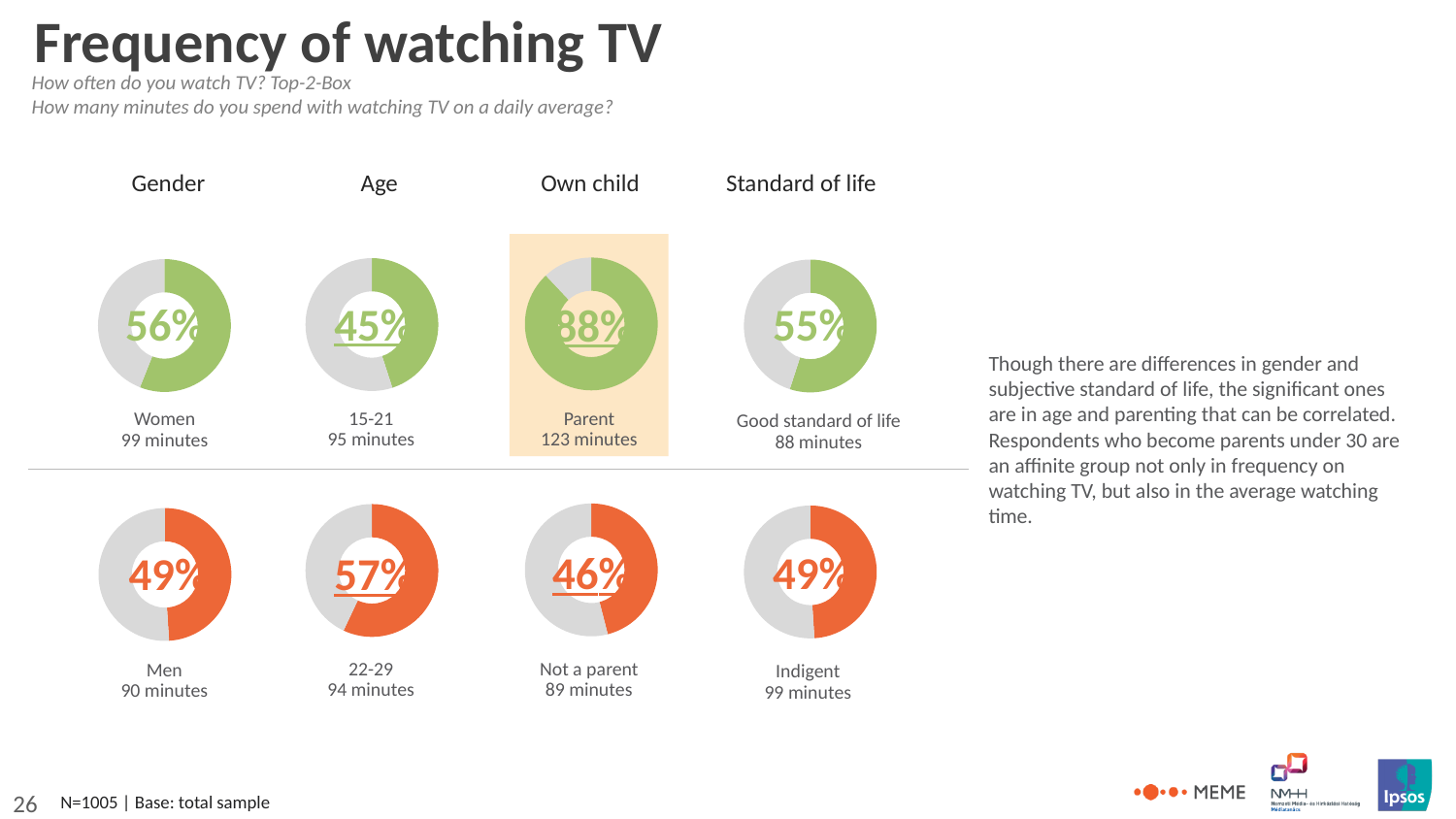
How many donut charts are shown on the slide? 8 What is the difference in daily minutes between the Parent group and the Not a parent group? 34 minutes What percentage is shown in the donut chart for Parent? 88% What percentage is shown in the donut chart for Women? 56% What colour is the filled segment in the donut charts in the bottom row (Men, 22-29, Not a parent, Indigent)? Orange What type of chart is used to show the percentages on this slide? Donut (pie) chart How many minutes per day are listed under the Men donut chart? 90 minutes Across all eight donut charts on the slide, which group has the highest percentage? Parent What percentage is shown in the donut chart for the 22-29 age group? 57% What is the difference in percentage points between the Parent donut chart and the Not a parent donut chart? 42 Across all eight donut charts on the slide, which group has the lowest percentage? 15-21 Which has the higher percentage: the Women donut chart or the Men donut chart? Women